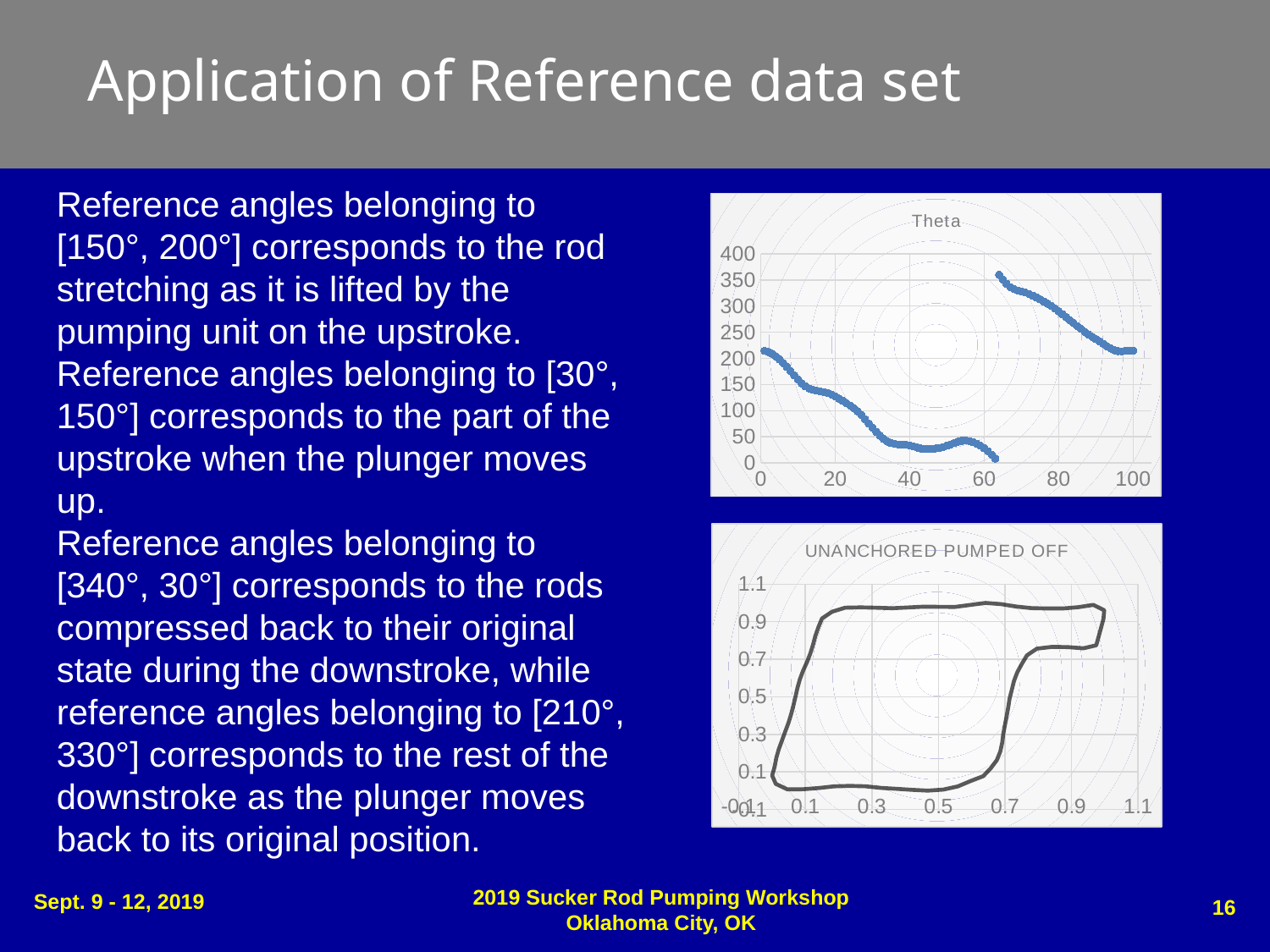
In the Theta chart, is the value at x = 80 greater or less than 250? greater In the Theta chart, what kind of chart is shown? scatter chart What is the title of the upper chart on the slide? Theta In the UNANCHORED PUMPED OFF chart, is the lowest point of the loop greater or less than 0.1 on the vertical axis? less In the Theta chart, do the values rise or fall as x goes from 70 to 100? fall In the Theta chart, is the value at x = 40 greater or less than 100? less What is the title of the lower chart on the slide? UNANCHORED PUMPED OFF In the Theta chart, do the values rise or fall as x goes from 0 to 60? fall In the Theta chart, what is the highest value shown on the vertical axis? 400